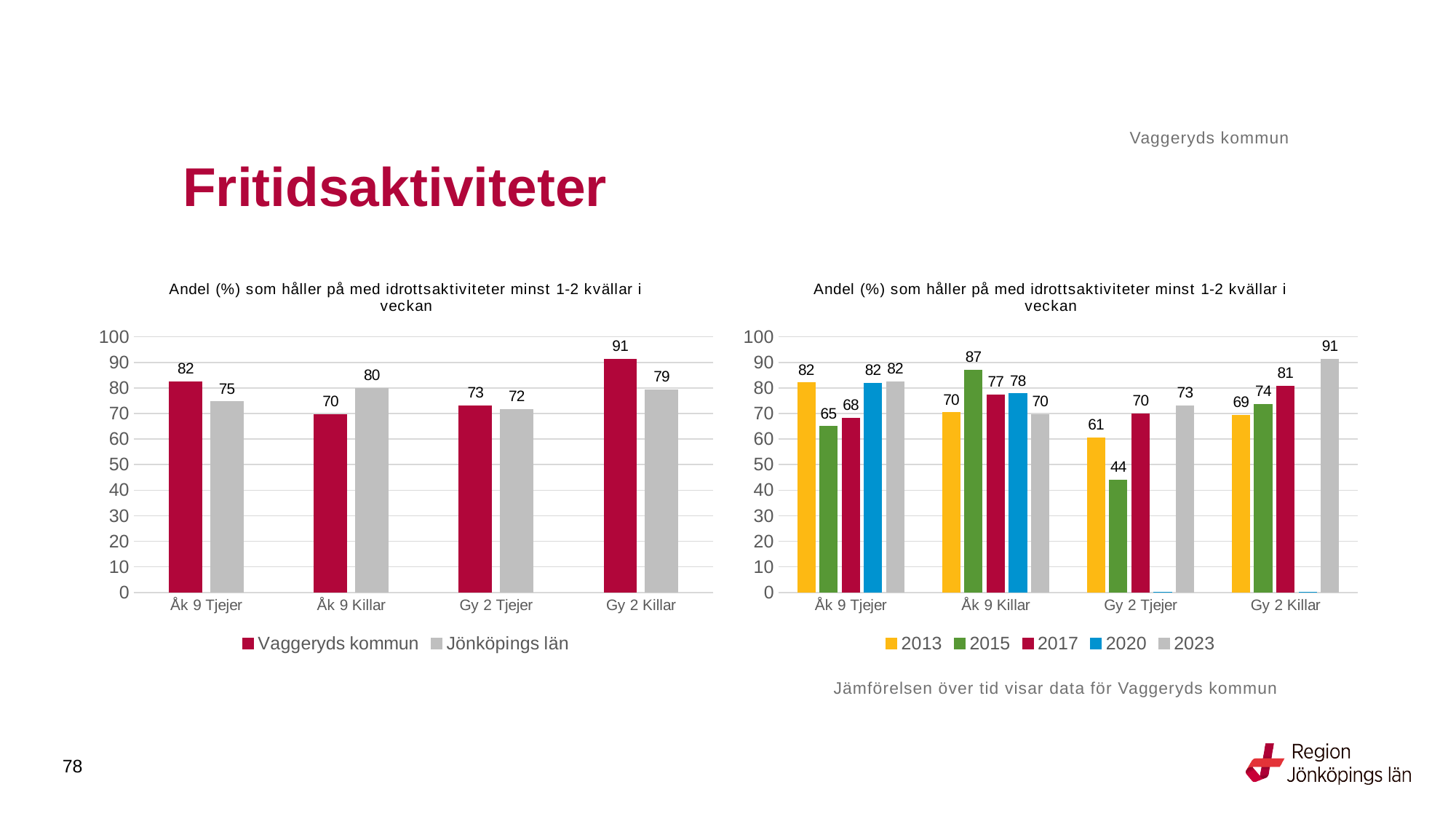
In the left chart, how many series does the legend list? 2 In the right chart, how many series does the legend list? 5 In the left chart, which is larger for Åk 9 Killar: Vaggeryds kommun or Jönköpings län? Jönköpings län In the left chart, which category has the lowest value for Vaggeryds kommun? Åk 9 Killar In the right chart, what is the difference between the 2023 and 2013 values for Gy 2 Killar? 22 In the right chart, what is the value for 2023 for Gy 2 Killar? 91 In the left chart, what is the difference between Vaggeryds kommun and Jönköpings län for Gy 2 Killar? 12 In the right chart, which year has the highest value for Åk 9 Killar? 2015 In the left chart, what is the value for Jönköpings län for Åk 9 Killar? 80 In the left chart, what is the value for Vaggeryds kommun for Gy 2 Killar? 91 What kind of chart is the right chart? Bar chart In the right chart, what is the value for 2015 for Gy 2 Tjejer? 44